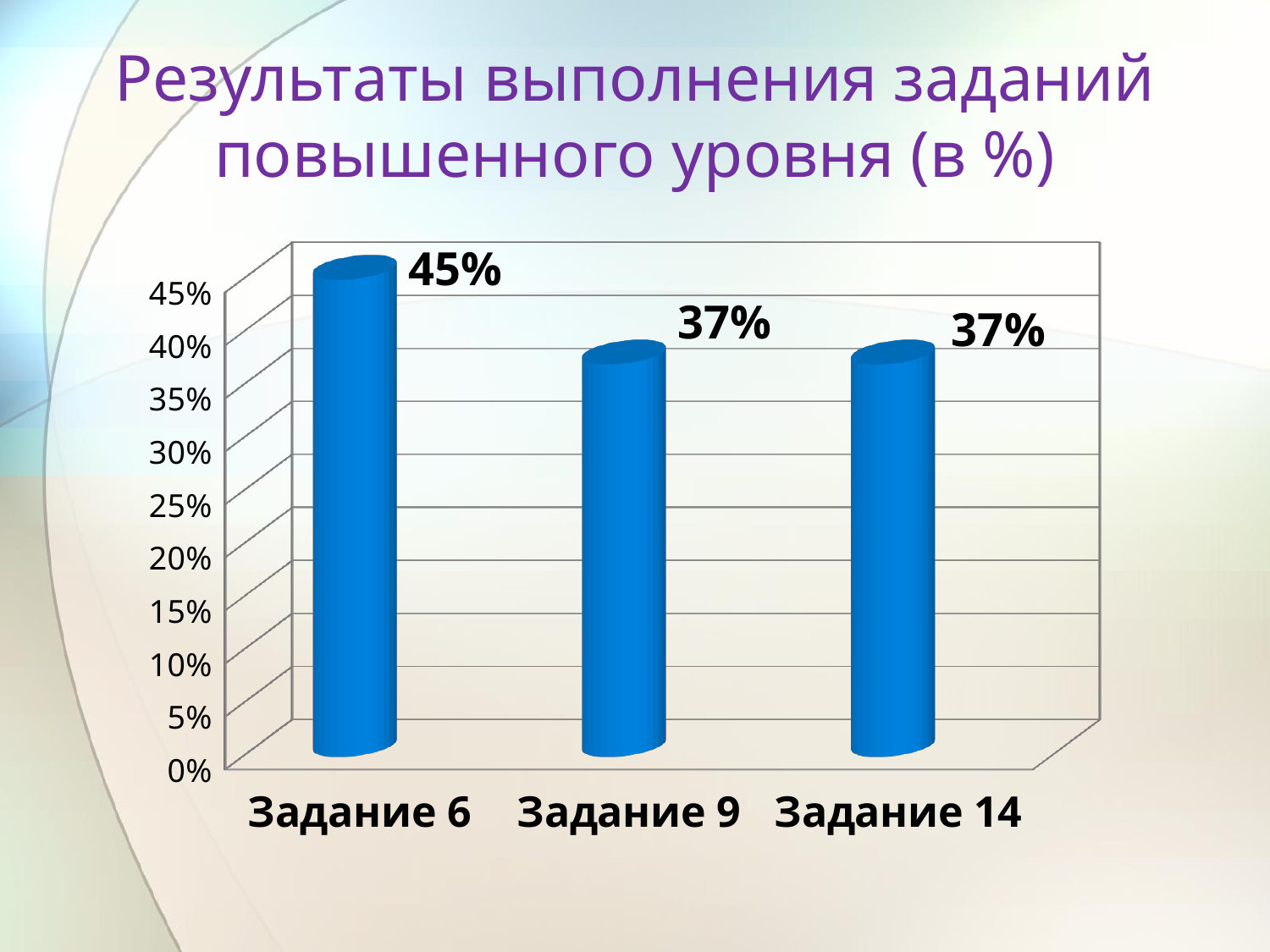
Which is larger, the value for Задание 6 or the value for Задание 14? Задание 6 What is the difference between the values for Задание 6 and Задание 9? 8% Do the values rise or fall from Задание 6 to Задание 9? fall Is the value for Задание 9 greater or less than 40%? less What is the value for Задание 6? 45% What kind of chart is shown on the slide? bar chart How many categories are shown on the x axis? 3 What is the value for Задание 14? 37% Which category has the highest value? Задание 6 Is the value for Задание 6 greater or less than 40%? greater What is the value for Задание 9? 37% What is the title of the slide? Результаты выполнения заданий повышенного уровня (в %)